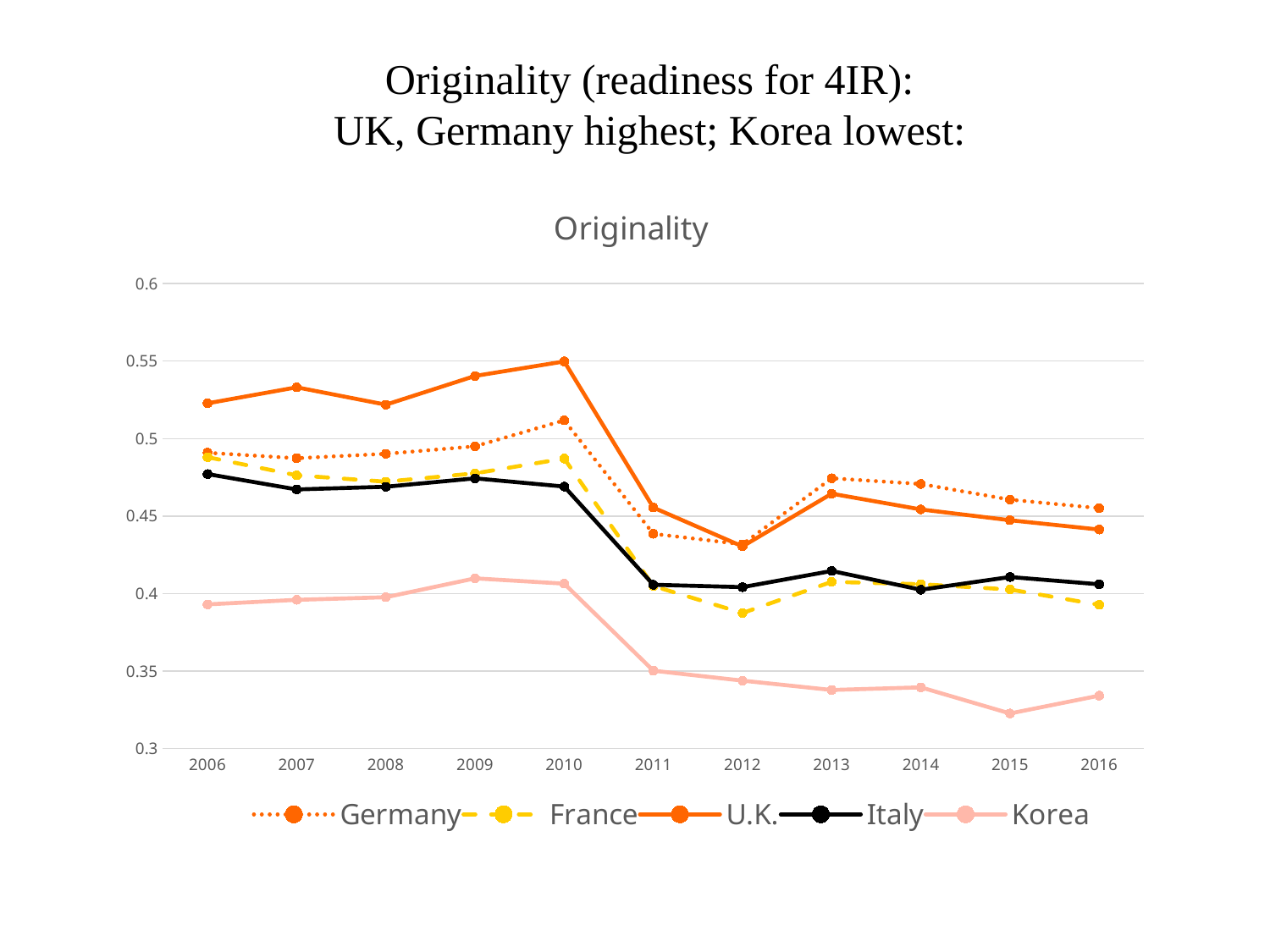
Is the value for Korea in 2015 greater or less than 0.35? less Which series has the lowest values across all years? Korea Which series has the highest value in 2010? U.K. Is the value for France in 2012 greater or less than 0.4? less In which year does the Korea series reach its lowest value? 2015 Is the value for the U.K. in 2006 greater or less than 0.5? greater How many years are shown on the x axis? 11 In which year does the U.K. series reach its highest value? 2010 What kind of chart is shown on the slide? line chart Does the Korea series rise or fall from 2011 to 2015? fall How many series does the legend list? 5 Which is larger in 2016, the value for Germany or the value for Italy? Germany